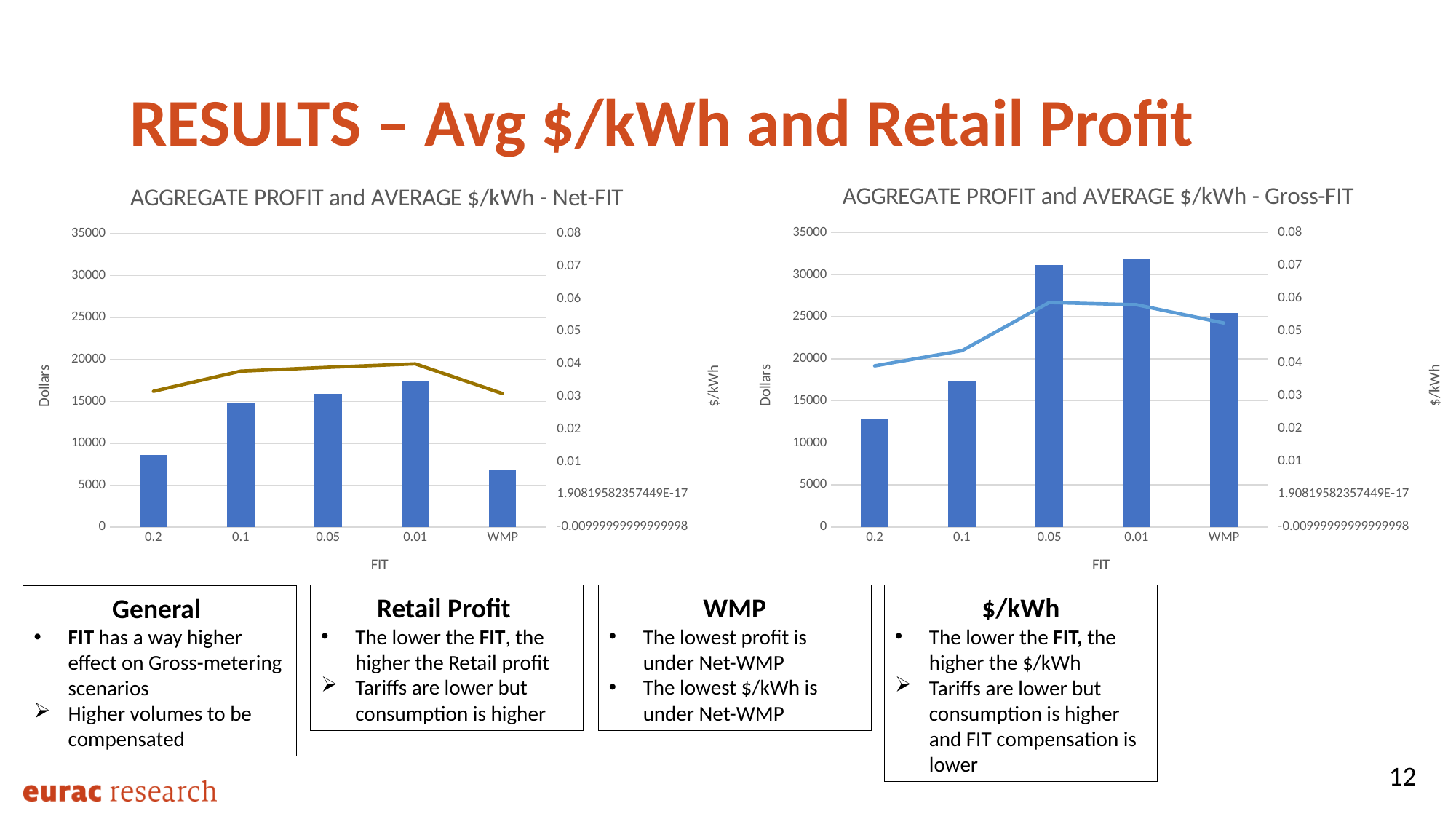
In the Net-FIT chart on the left, which bar is taller, 0.1 or WMP? 0.1 How many categories are shown on the x axis of the Net-FIT chart on the left? 5 In the Net-FIT chart on the left, is the bar for 0.2 greater or less than 10000? less In the Gross-FIT chart on the right, which category has the shortest bar? 0.2 In the Gross-FIT chart on the right, does the line rise or fall from 0.2 to 0.05? rise In the Gross-FIT chart on the right, is the bar for 0.05 greater or less than 30000? greater In the Gross-FIT chart on the right, is the bar for WMP greater or less than 20000? greater In the Gross-FIT chart on the right, which bar is taller, 0.1 or 0.2? 0.1 What kind of chart is the Gross-FIT chart on the right? Bar chart with a line series In the Net-FIT chart on the left, which category has the shortest bar? WMP In the Net-FIT chart on the left, which FIT category has the tallest bar? 0.01 What is the x-axis title of the Net-FIT chart on the left? FIT